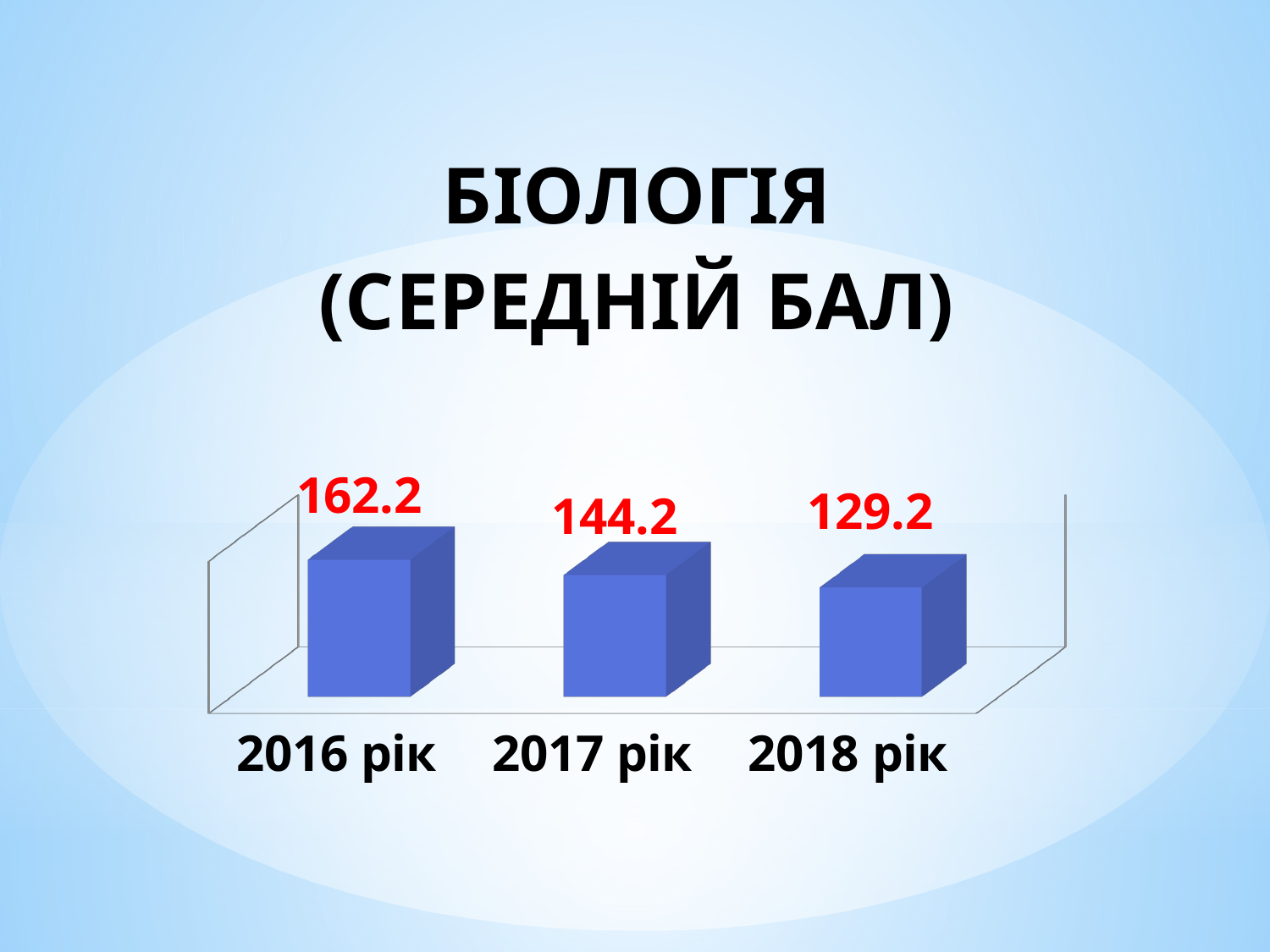
Which year has the highest value? 2016 рік How many categories are shown in the chart? 3 What is the value for 2017 рік? 144.2 What kind of chart is shown on the slide? bar chart What is the difference between the values for 2016 рік and 2017 рік? 18 Which is larger, the value for 2017 рік or the value for 2018 рік? 2017 рік What is the difference between the values for 2016 рік and 2018 рік? 33 What is the value for 2016 рік? 162.2 What is the difference between the values for 2017 рік and 2018 рік? 15 What is the value for 2018 рік? 129.2 Which year has the lowest value? 2018 рік Do the values rise or fall from 2016 рік to 2018 рік? fall